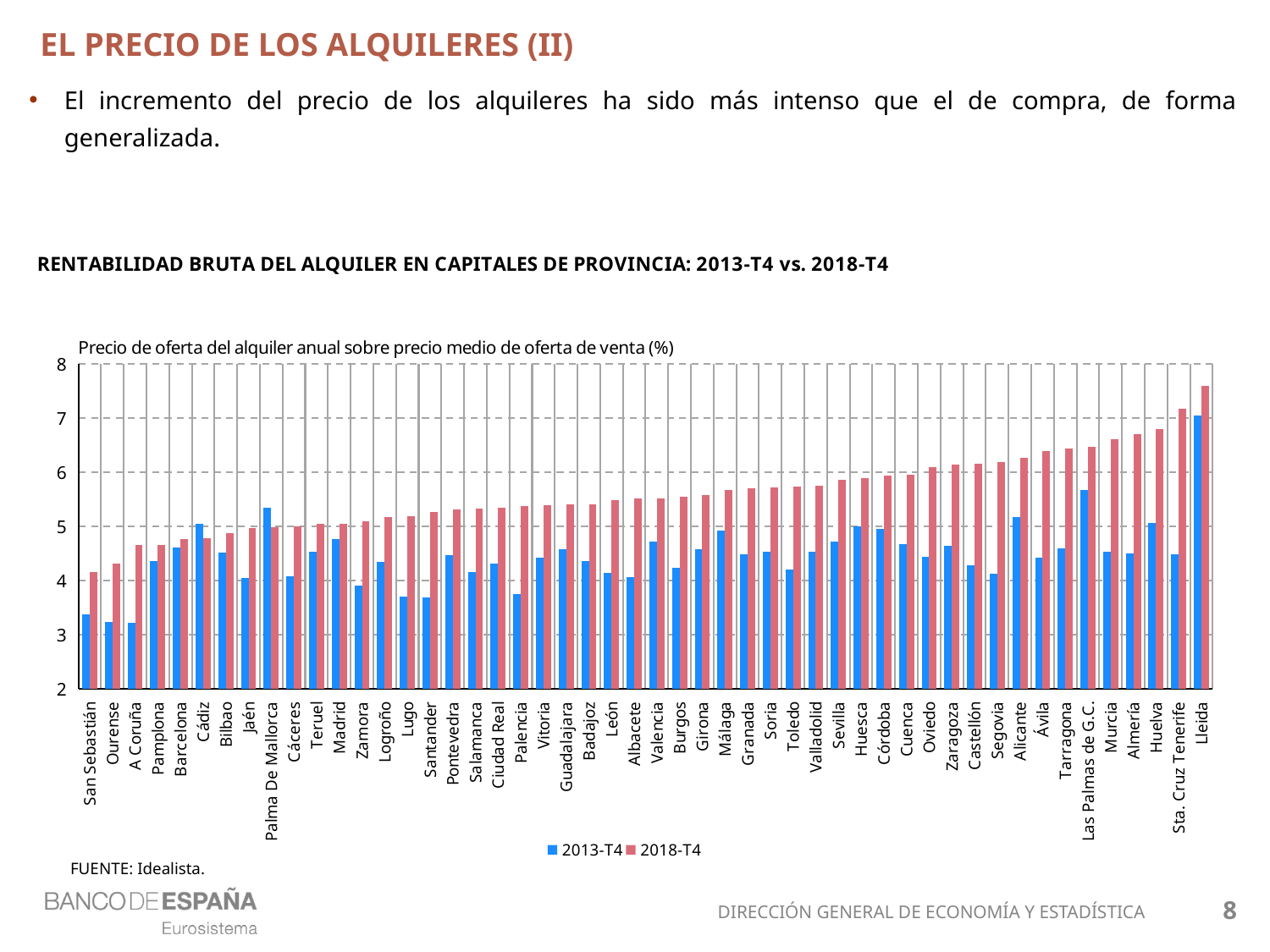
Which capital has the highest 2018-T4 value? Lleida Is the 2018-T4 value for Huelva greater or less than 6? greater Which capital has the lowest 2018-T4 value? San Sebastián Is the 2013-T4 value for San Sebastián greater or less than 4? less Is the 2013-T4 value for Las Palmas de G.C. greater or less than 5? greater For Cádiz, which is larger: the 2013-T4 value or the 2018-T4 value? 2013-T4 How many series does the legend list? 2 How many provincial capitals are shown on the x axis? 50 What kind of chart is shown on the slide? Bar chart Do the 2018-T4 values rise or fall moving from left to right along the x axis? Rise What source is cited for the chart? Idealista